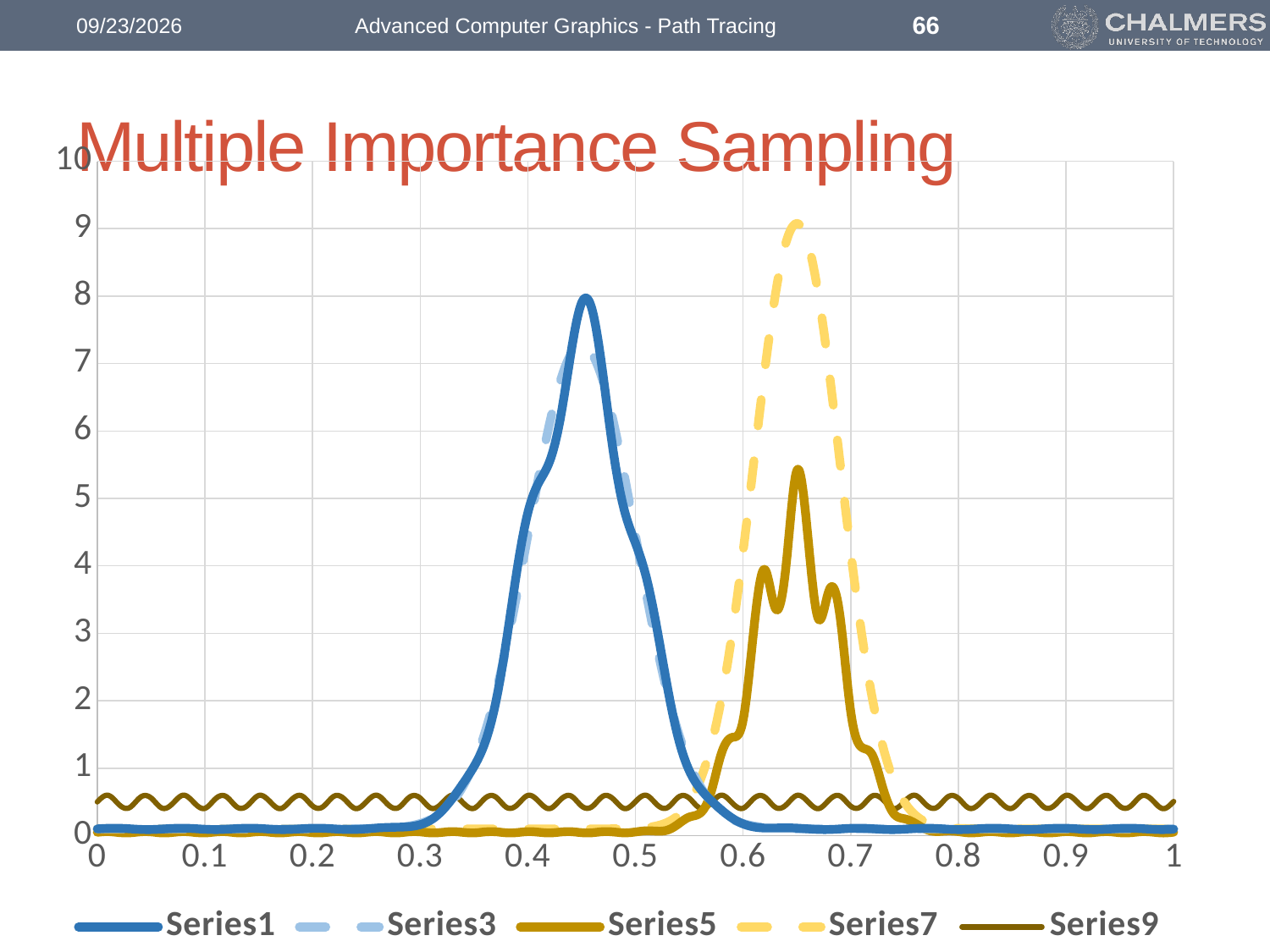
How many series does the legend list? 5 What is the title of the slide containing the chart? Multiple Importance Sampling Is the peak value of Series7 greater or less than 8? greater Which two series are drawn with dashed lines? Series3 and Series7 Is the x position of the Series1 peak greater or less than 0.5? less Is the peak value of Series1 greater or less than 7? greater Which series reaches the highest peak value on the chart? Series7 Which series has a higher peak, Series1 or Series5? Series1 Which series has a higher peak, Series7 or Series1? Series7 What kind of chart is shown on the slide? line chart